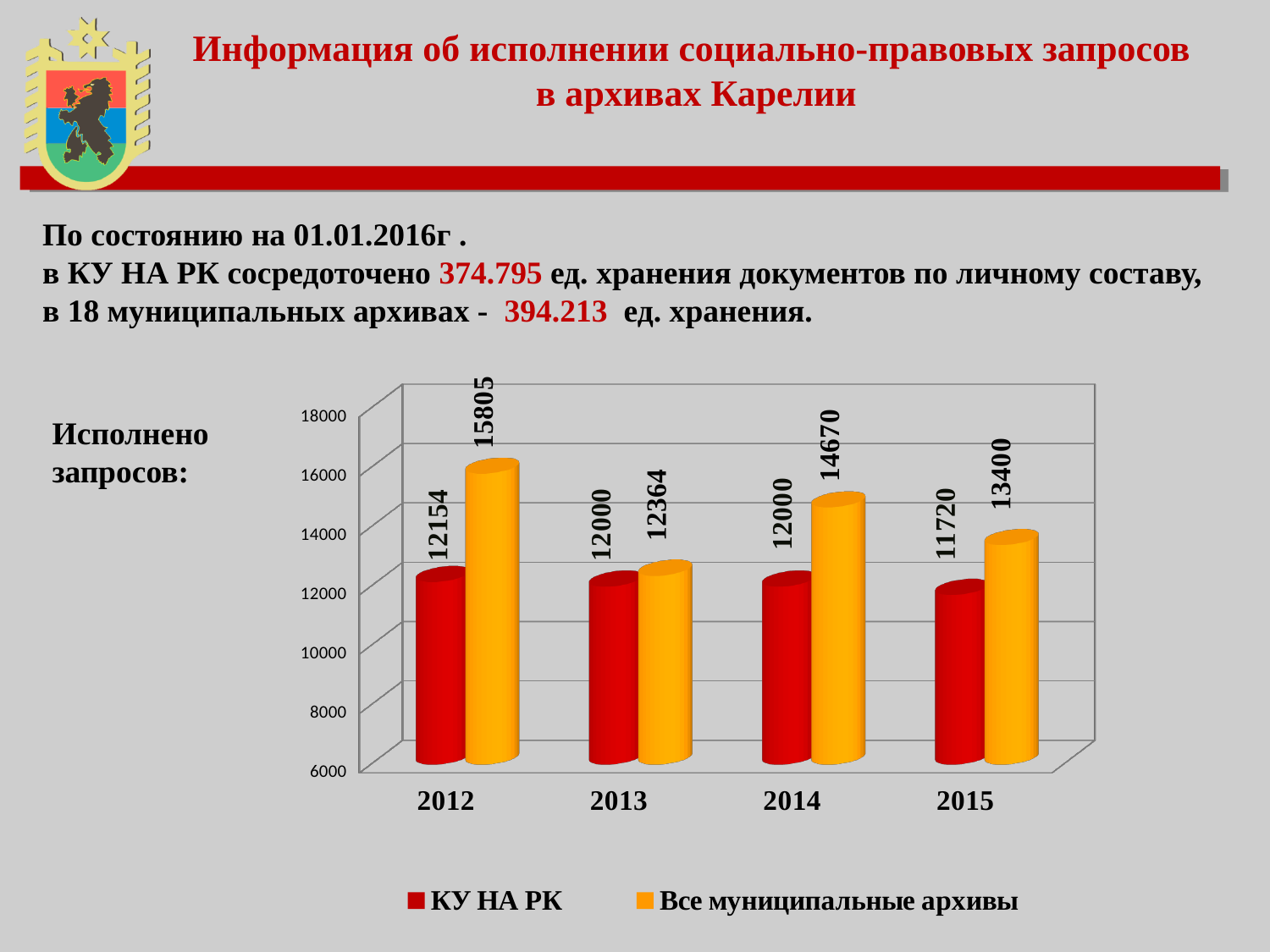
What value is shown for КУ НА РК in 2015? 11720 What kind of chart is shown on the slide? Bar chart What is the difference between Все муниципальные архивы and КУ НА РК in 2012? 3651 Which is larger in 2015: КУ НА РК or Все муниципальные архивы? Все муниципальные архивы What value is shown for Все муниципальные архивы in 2014? 14670 What value is shown for КУ НА РК in 2012? 12154 In which year is the value for КУ НА РК lowest? 2015 How many years are shown on the x axis? 4 In which year is the value for Все муниципальные архивы highest? 2012 What value is shown for Все муниципальные архивы in 2013? 12364 How many series does the legend list? 2 Which colour represents КУ НА РК in the chart? Red